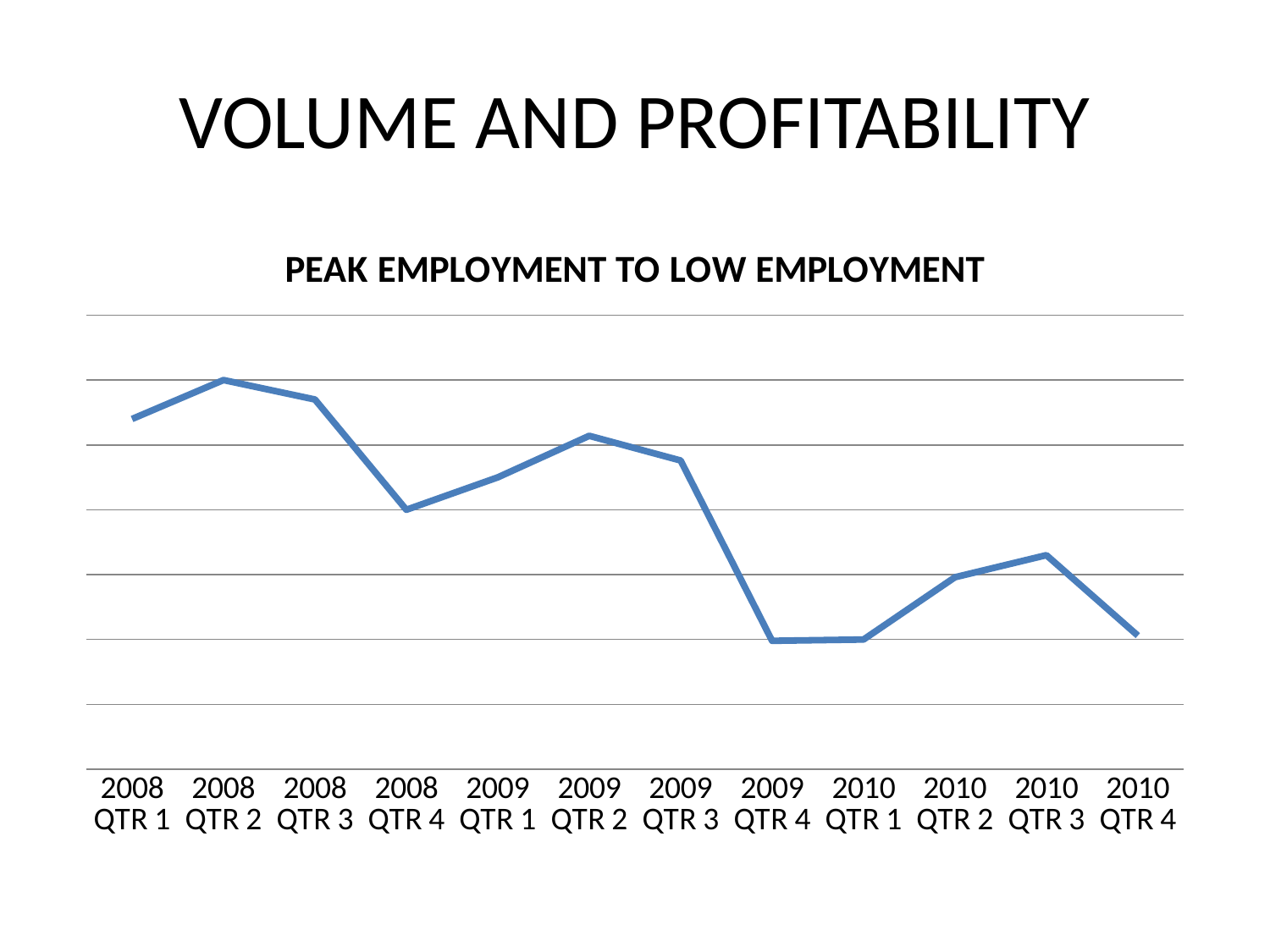
Does the line rise or fall from 2009 QTR 3 to 2009 QTR 4? fall Which quarter has the highest value on the line? 2008 QTR 2 What kind of chart is shown on the slide? line chart Does the line rise or fall from 2008 QTR 4 to 2009 QTR 2? rise What colour is the plotted line? blue Which is higher, the value for 2008 QTR 2 or the value for 2008 QTR 4? 2008 QTR 2 What is the title of the chart? PEAK EMPLOYMENT TO LOW EMPLOYMENT Which is higher, the value for 2009 QTR 2 or the value for 2009 QTR 4? 2009 QTR 2 Which is higher, the value for 2008 QTR 1 or the value for 2010 QTR 1? 2008 QTR 1 How many quarters are plotted along the x axis? 12 Overall, does the line rise or fall from 2008 QTR 1 to 2010 QTR 4? fall